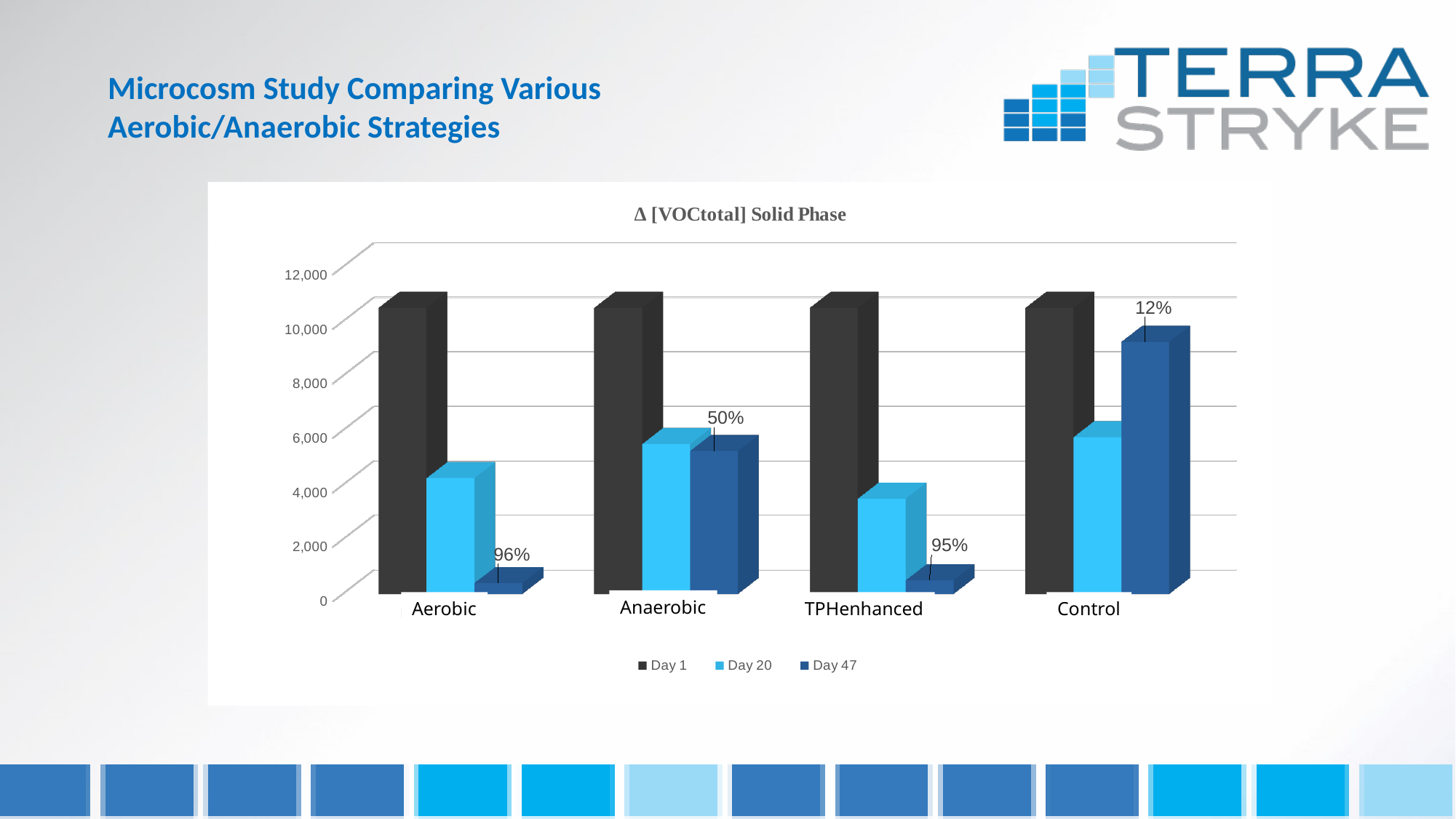
What percentage label is printed above the Day 47 bar for Aerobic? 96% What percentage label is printed above the Day 47 bar for Control? 12% Which category has the lowest Day 20 value? TPHenhanced Is the Day 47 value for Control greater or less than 8,000? greater How many series does the legend list? 3 Is the Day 47 value for TPHenhanced greater or less than 2,000? less What is the title of the chart? Δ [VOCtotal] Solid Phase Which is larger, the Day 20 value for Anaerobic or the Day 20 value for Aerobic? Anaerobic Which category has the highest Day 47 value? Control Which series does the legend list last? Day 47 How many categories are shown on the x axis? 4 What kind of chart is shown on the slide? bar chart